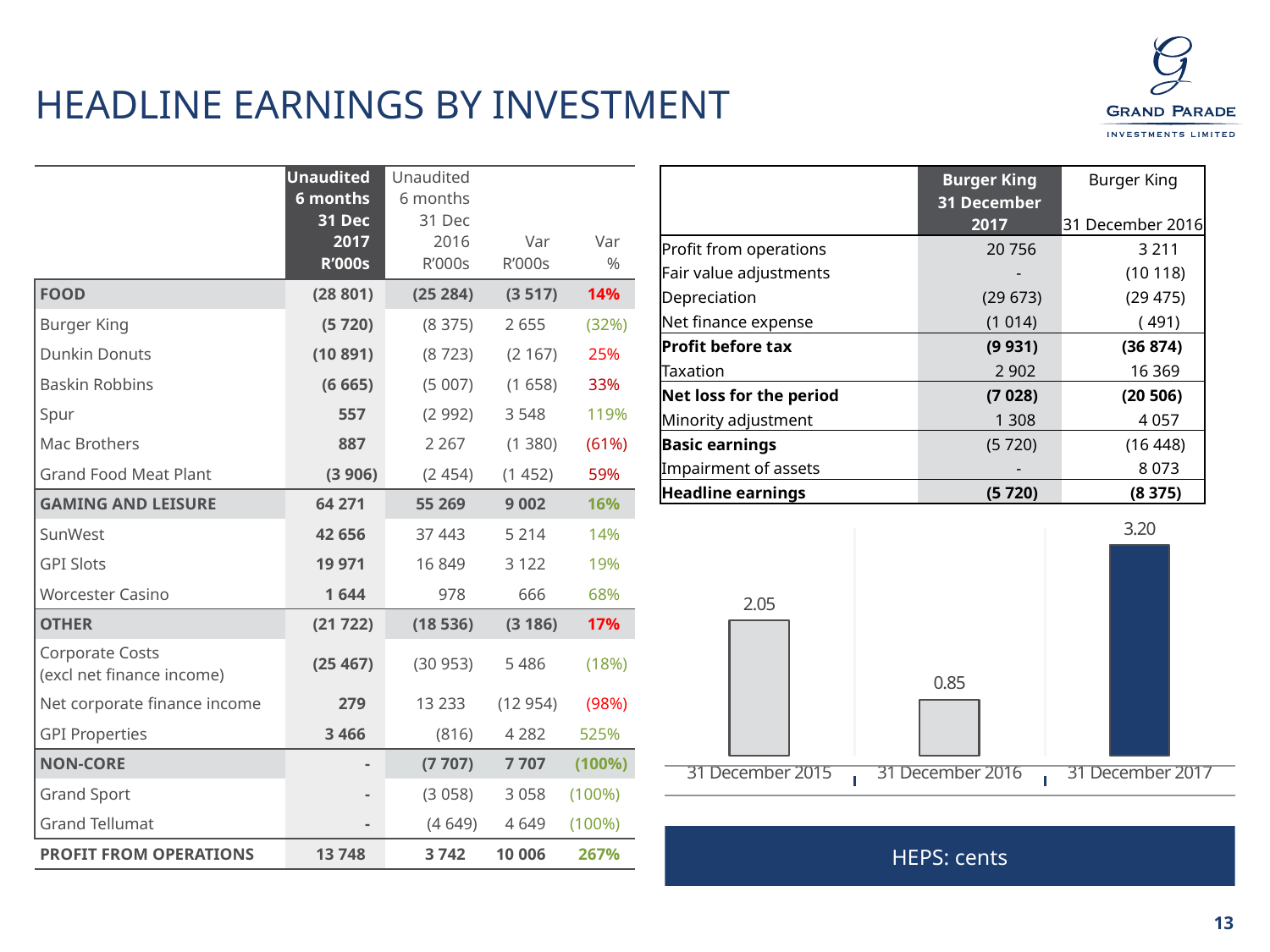
In the HEPS: cents chart, what is the difference between the HEPS for 31 December 2015 and 31 December 2016? 1.20 What is the HEPS value for 31 December 2017 in the HEPS: cents chart? 3.20 In the HEPS: cents chart, is the HEPS for 31 December 2015 or 31 December 2017 larger? 31 December 2017 In the HEPS: cents chart, what is the difference between the HEPS for 31 December 2017 and 31 December 2016? 2.35 How many periods are shown in the HEPS: cents chart? 3 In the HEPS: cents chart, does HEPS rise or fall from 31 December 2016 to 31 December 2017? Rise In the HEPS: cents chart, which bar is coloured dark navy rather than grey? 31 December 2017 What is the HEPS value for 31 December 2016 in the HEPS: cents chart? 0.85 Which period has the lowest HEPS in the HEPS: cents chart? 31 December 2016 What is the HEPS value for 31 December 2015 in the HEPS: cents chart? 2.05 Which period has the highest HEPS in the HEPS: cents chart? 31 December 2017 What kind of chart is the HEPS: cents chart? Bar chart